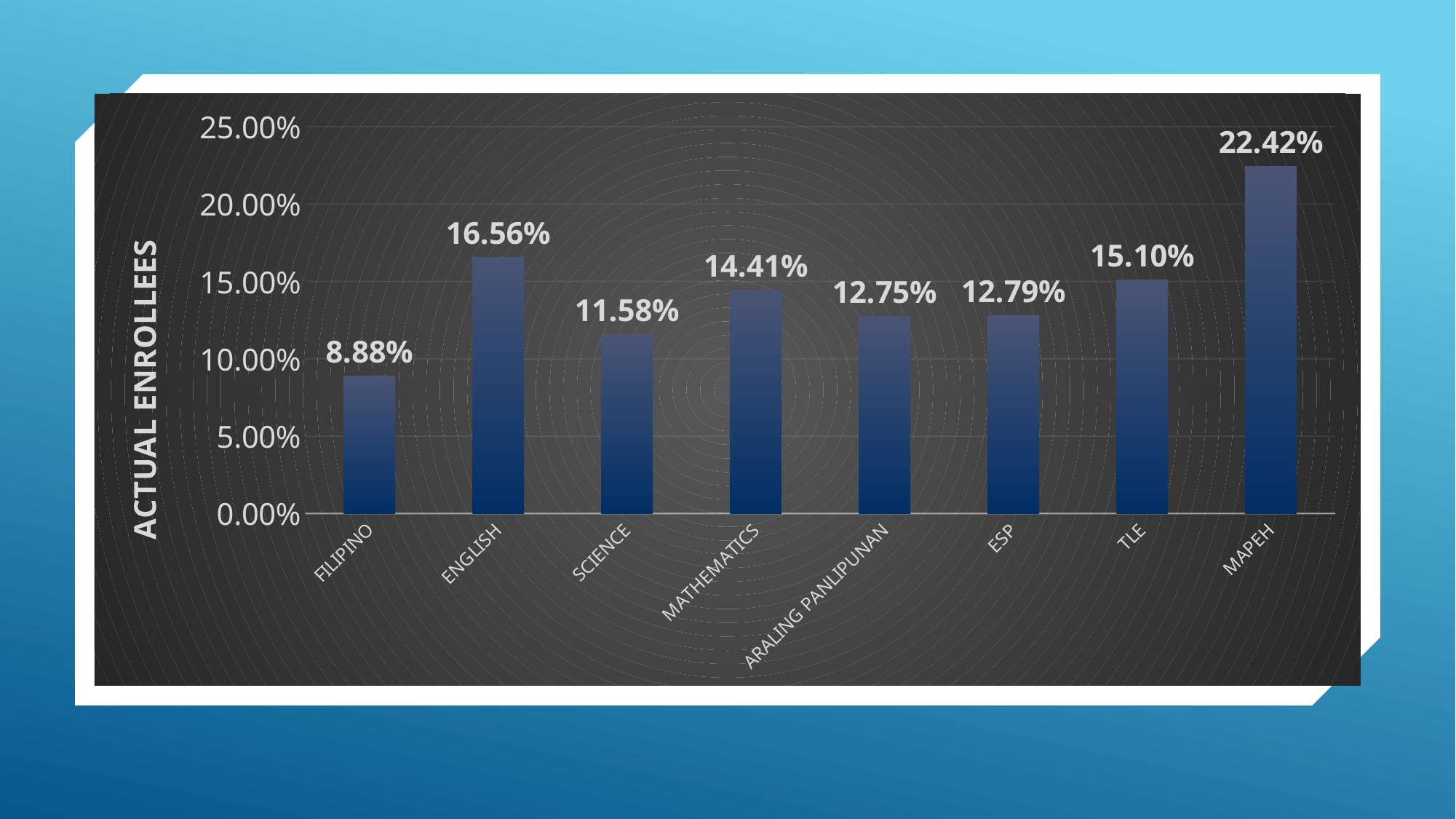
What is the label on the vertical axis? ACTUAL ENROLLEES What is the value for FILIPINO? 8.88% What is the difference between the values for SCIENCE and FILIPINO? 2.70% Which category has the highest value? MAPEH What is the value for TLE? 15.10% Which category has the lowest value? FILIPINO What is the value for MATHEMATICS? 14.41% Which is larger, the value for ENGLISH or the value for TLE? ENGLISH Is the value for SCIENCE greater or less than 10.00%? greater How many categories are shown on the x axis? 8 What is the difference between the values for MAPEH and ENGLISH? 5.86% What kind of chart is shown on the slide? bar chart